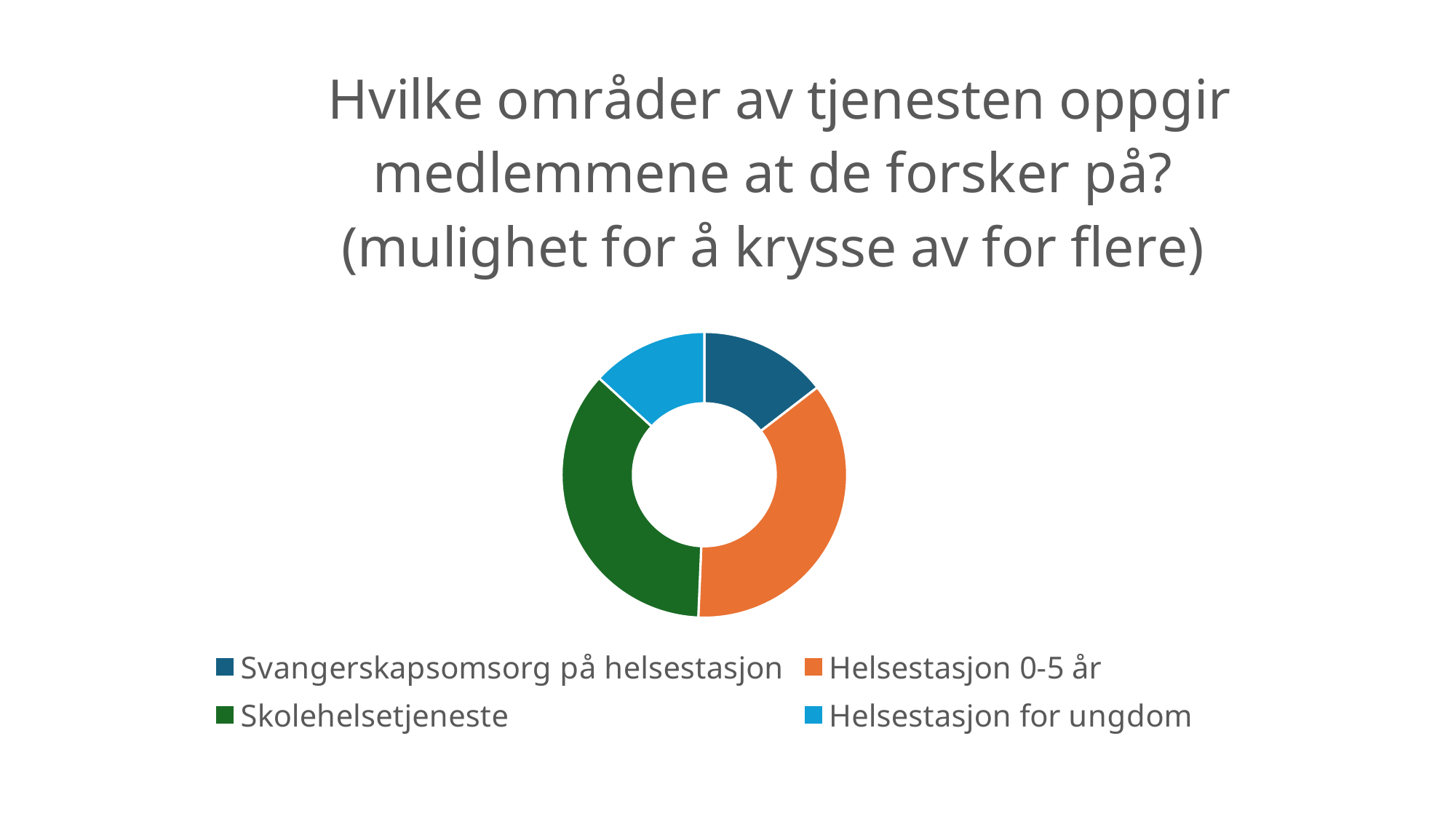
Which category is shown in green? Skolehelsetjeneste Which is larger, the slice for Skolehelsetjeneste or the slice for Svangerskapsomsorg på helsestasjon? Skolehelsetjeneste Which is larger, the slice for Skolehelsetjeneste or the slice for Helsestasjon for ungdom? Skolehelsetjeneste Which is larger, the slice for Helsestasjon 0-5 år or the slice for Svangerskapsomsorg på helsestasjon? Helsestasjon 0-5 år How many categories does the chart show? 4 How many entries does the legend list? 4 What is the title of the chart? Hvilke områder av tjenesten oppgir medlemmene at de forsker på? (mulighet for å krysse av for flere) What kind of chart is shown on the slide? Doughnut chart